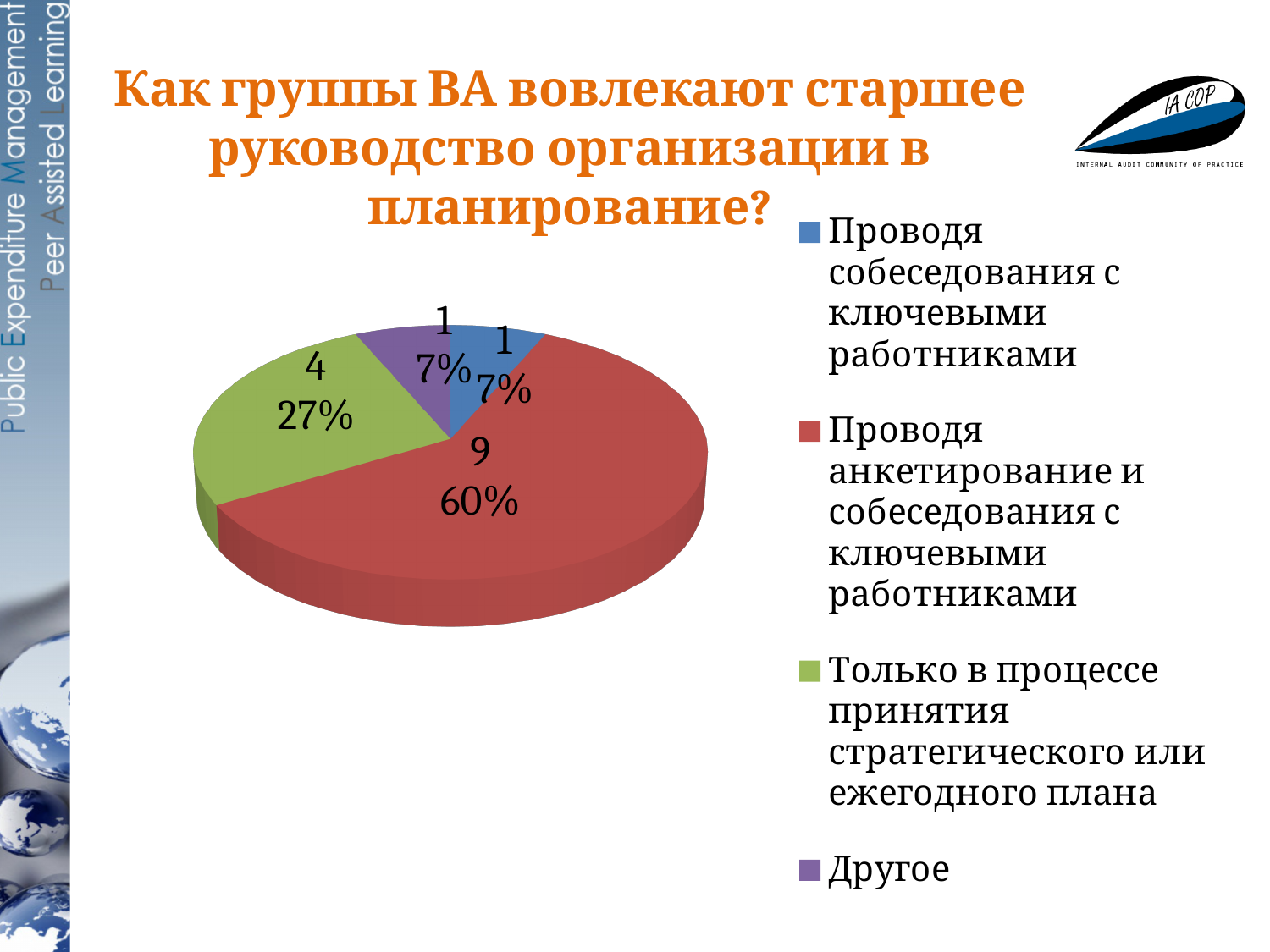
What colour is the slice for "Проводя анкетирование и собеседования с ключевыми работниками"? Red Which is larger: the slice for "Только в процессе принятия стратегического или ежегодного плана" or the slice for "Другое"? Только в процессе принятия стратегического или ежегодного плана How many slices does the pie chart have? 4 What is the count value shown for "Проводя анкетирование и собеседования с ключевыми работниками"? 9 What share of the pie does "Только в процессе принятия стратегического или ежегодного плана" represent? 27% What kind of chart is shown on the slide? Pie chart What share of the pie does "Другое" represent? 7% What is the difference in count between "Проводя анкетирование и собеседования с ключевыми работниками" and "Только в процессе принятия стратегического или ежегодного плана"? 5 What share of the pie does "Проводя анкетирование и собеседования с ключевыми работниками" represent? 60% Which category has the largest slice of the pie? Проводя анкетирование и собеседования с ключевыми работниками How many entries does the legend list? 4 What is the count value shown for "Только в процессе принятия стратегического или ежегодного плана"? 4